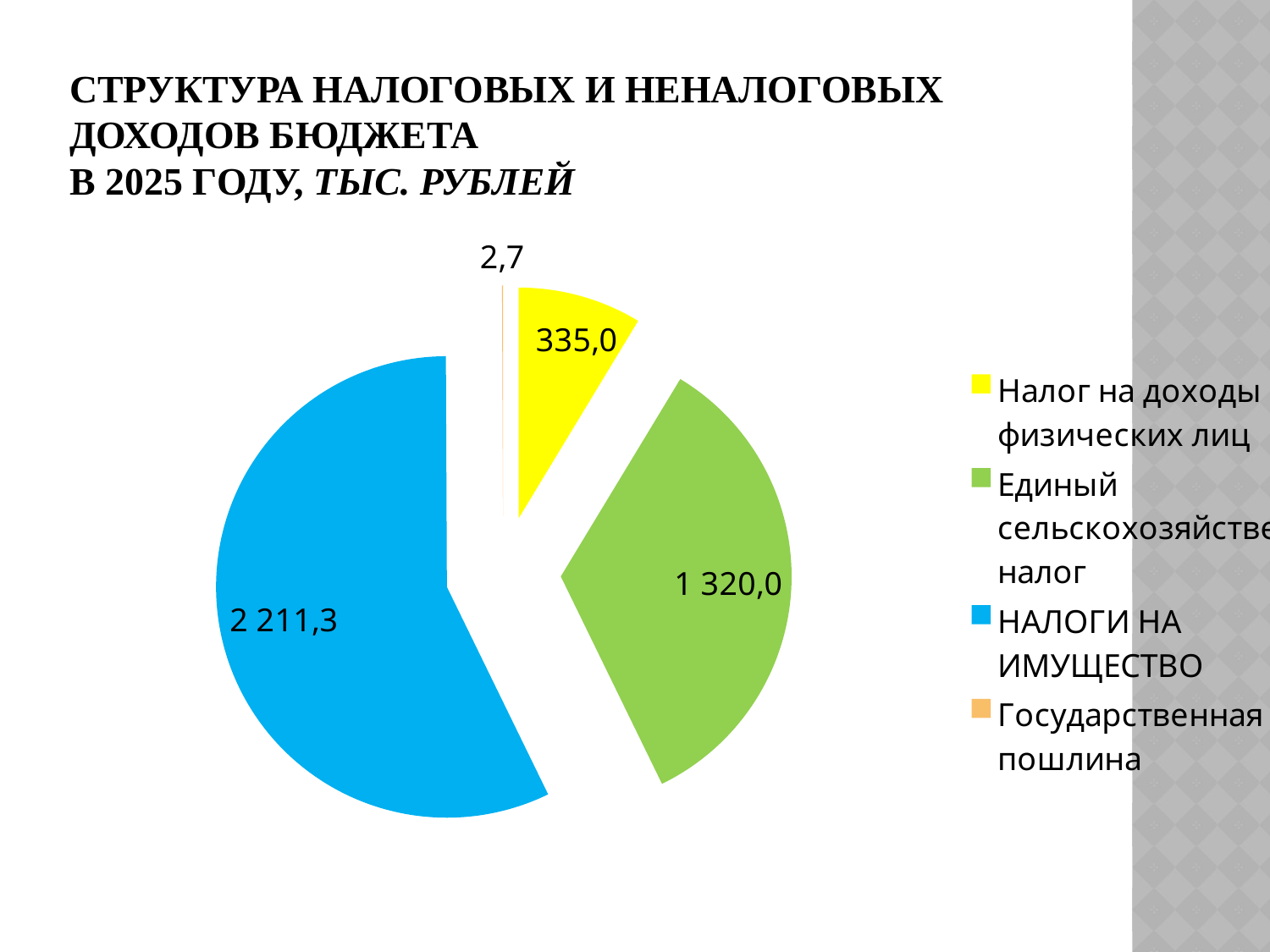
What is the value for Налог на доходы физических лиц? 335,0 How many categories does the legend list? 4 What is the value for Единый сельскохозяйственный налог? 1 320,0 Which category has the largest slice of the pie? НАЛОГИ НА ИМУЩЕСТВО What is the difference between the values for Налог на доходы физических лиц and Государственная пошлина? 332,3 What type of chart is shown on the slide? pie chart Which is larger: Единый сельскохозяйственный налог or Налог на доходы физических лиц? Единый сельскохозяйственный налог What colour is the slice for НАЛОГИ НА ИМУЩЕСТВО? blue What is the value for НАЛОГИ НА ИМУЩЕСТВО? 2 211,3 What is the difference between the values for НАЛОГИ НА ИМУЩЕСТВО and Единый сельскохозяйственный налог? 891,3 What is the value for Государственная пошлина? 2,7 Which category has the smallest slice of the pie? Государственная пошлина